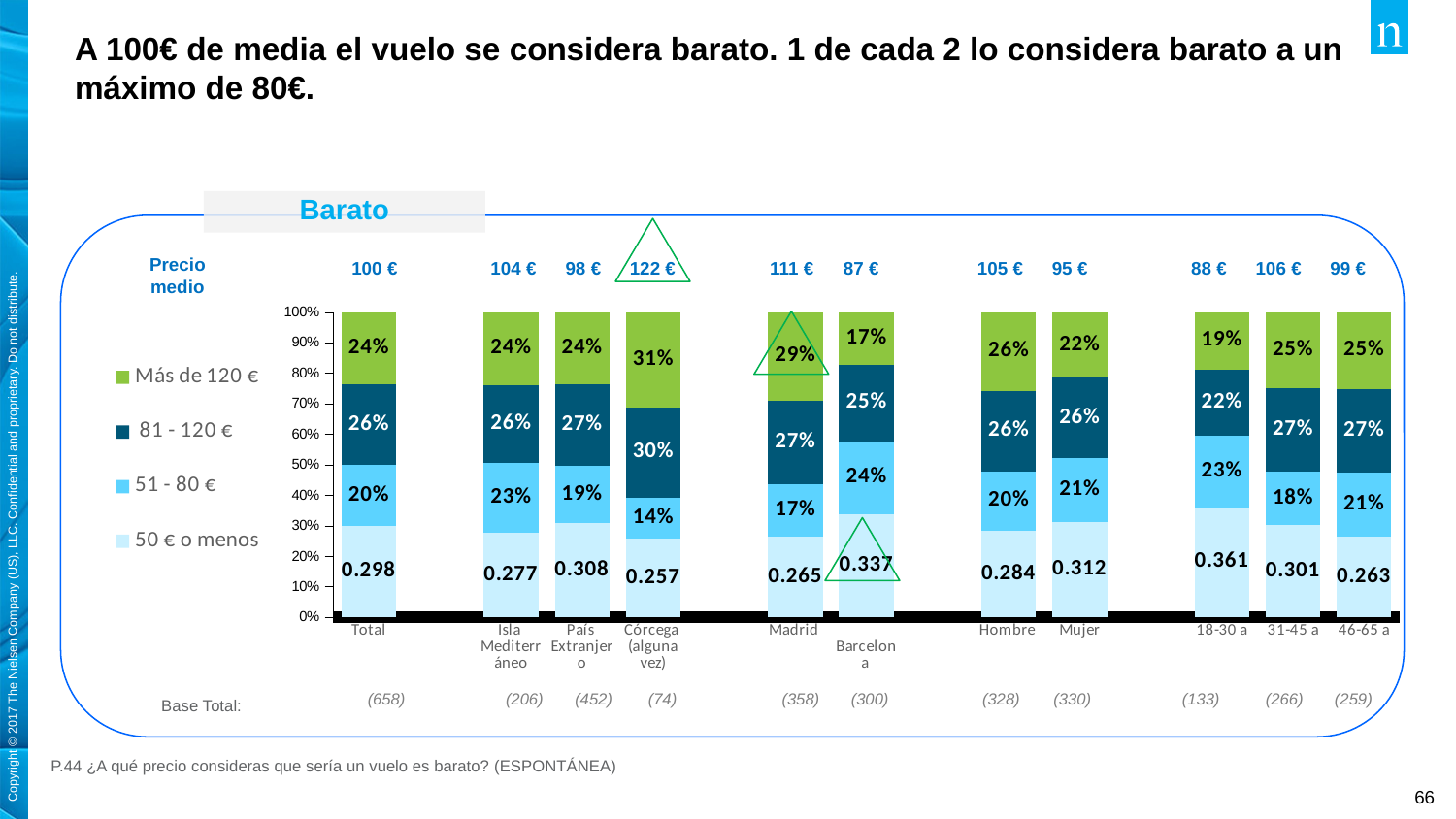
Which category has the highest 'Más de 120 €' share? Córcega (alguna vez) What is the value of the '50 € o menos' segment for the 18-30 a group? 0.361 Which has a larger '51 - 80 €' share, Isla Mediterráneo or País Extranjero? Isla Mediterráneo How many categories are shown along the x axis? 11 What kind of chart is shown on the slide? Stacked bar chart Which category has the lowest '51 - 80 €' share? Córcega (alguna vez) What is the value of the '81 - 120 €' segment for the 31-45 a group? 27% What is the difference between the 'Más de 120 €' values for Madrid and Barcelona? 12 percentage points How many series does the legend list? 4 What is the value of the '51 - 80 €' segment for Córcega (alguna vez)? 14% What is the 'Precio medio' shown above the Córcega (alguna vez) bar? 122 € What is the value of the 'Más de 120 €' segment for the Total bar? 24%